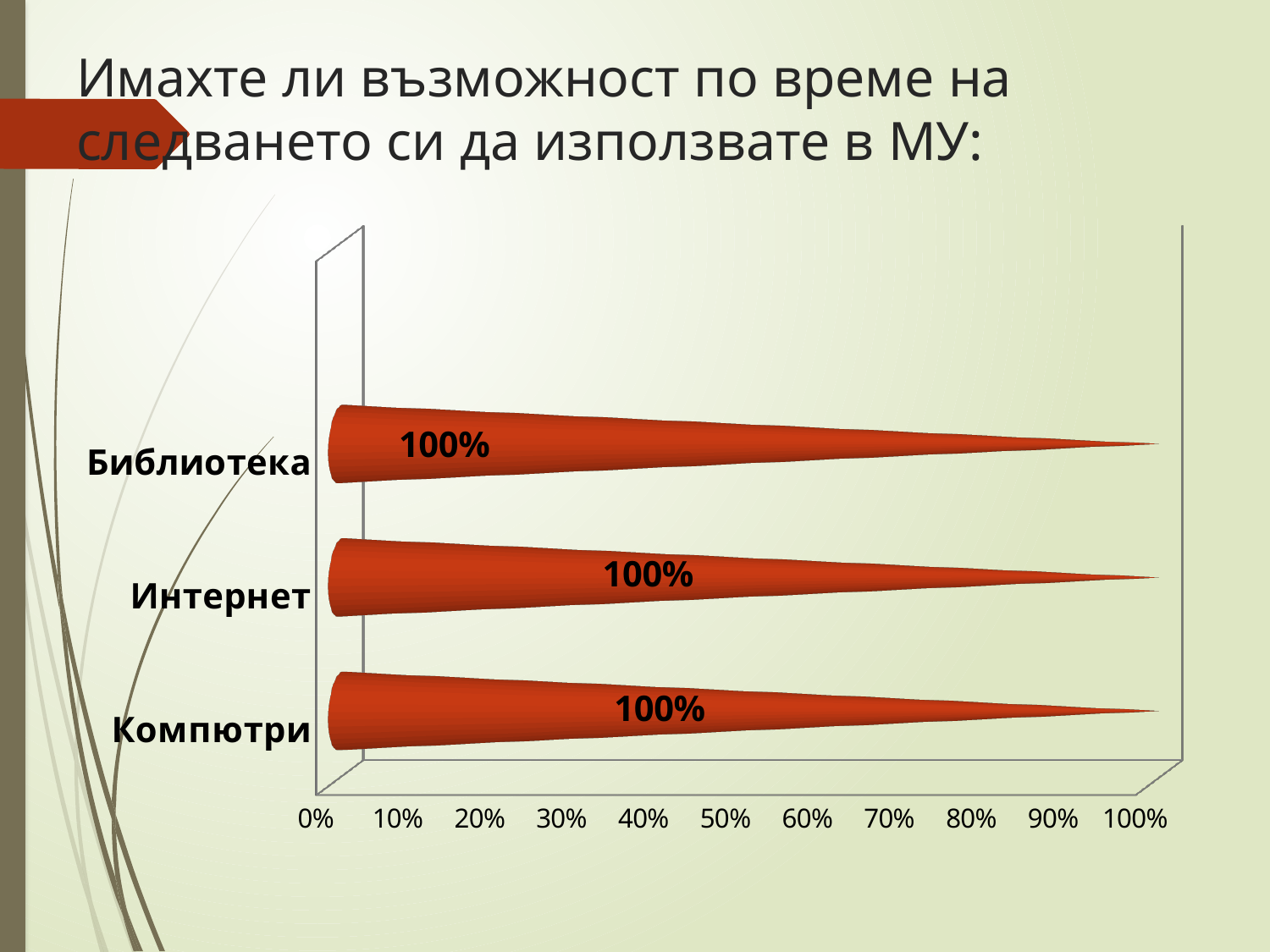
What is the value for Компютри? 100% How many categories are shown on the chart? 3 What colour are the bars on the chart? red Is the value for Компютри greater or less than 50%? greater What is the value for Библиотека? 100% Do all three categories have the same value? yes What is the value for Интернет? 100% What is the highest value shown on the x axis? 100% What kind of chart is shown on the slide? bar chart What is the difference between the values for Библиотека and Интернет? 0% Is the value for Интернет greater or less than 90%? greater